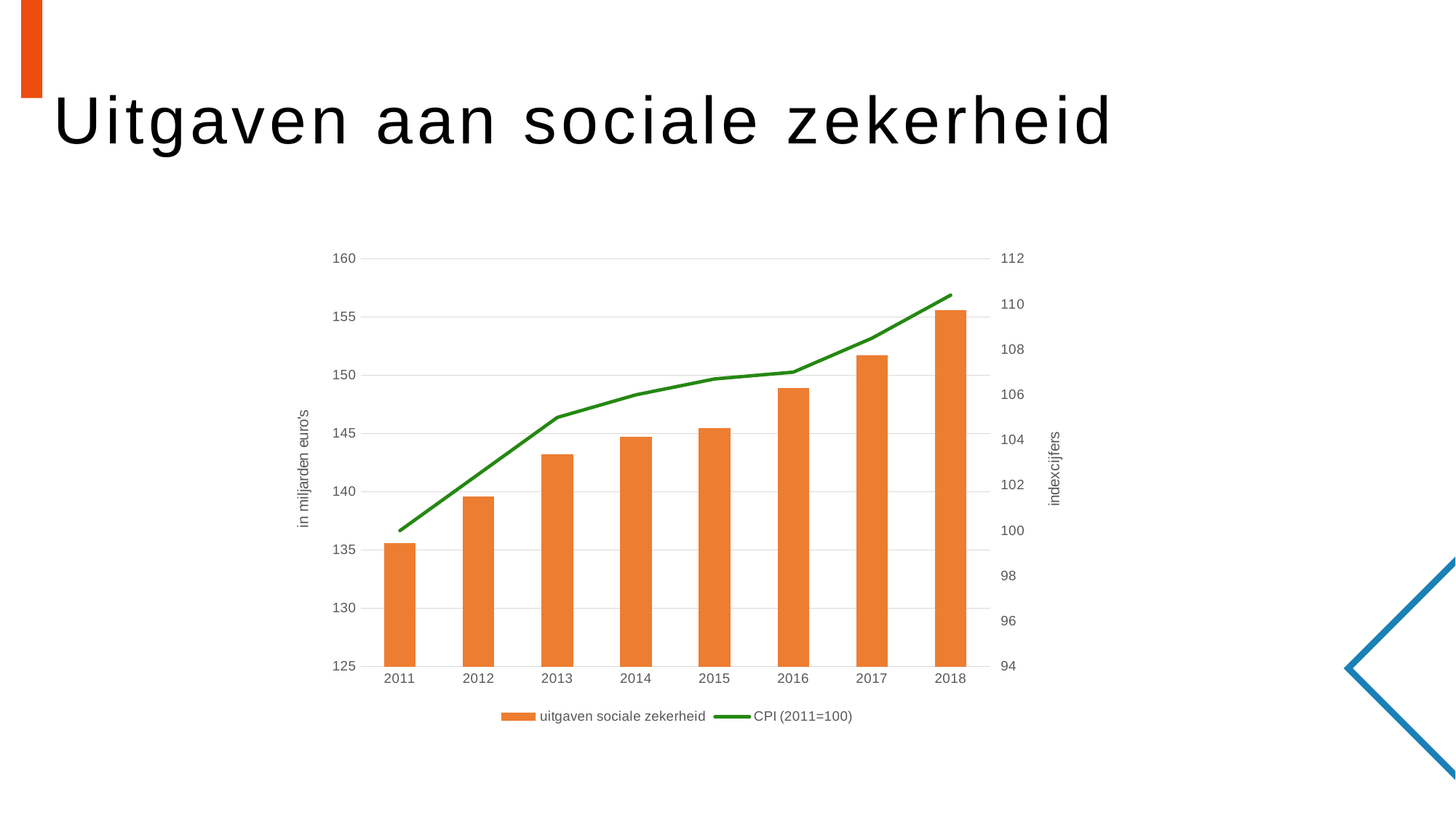
Which year has the highest value for uitgaven sociale zekerheid? 2018 What is the CPI (2011=100) value for 2011? 100 Which is larger, the uitgaven sociale zekerheid in 2014 or in 2017? 2017 Is the value for uitgaven sociale zekerheid in 2016 greater or less than 145? greater How many series does the legend list? 2 What kind of chart is shown on the slide? A combined bar and line chart Is the value for uitgaven sociale zekerheid in 2011 greater or less than 140? less Which year has the lowest value for uitgaven sociale zekerheid? 2011 Is the value for uitgaven sociale zekerheid in 2018 greater or less than 150? greater How many years are shown on the x axis? 8 What is the label of the right-hand vertical axis? indexcijfers Do the values for uitgaven sociale zekerheid rise or fall from 2011 to 2018? rise